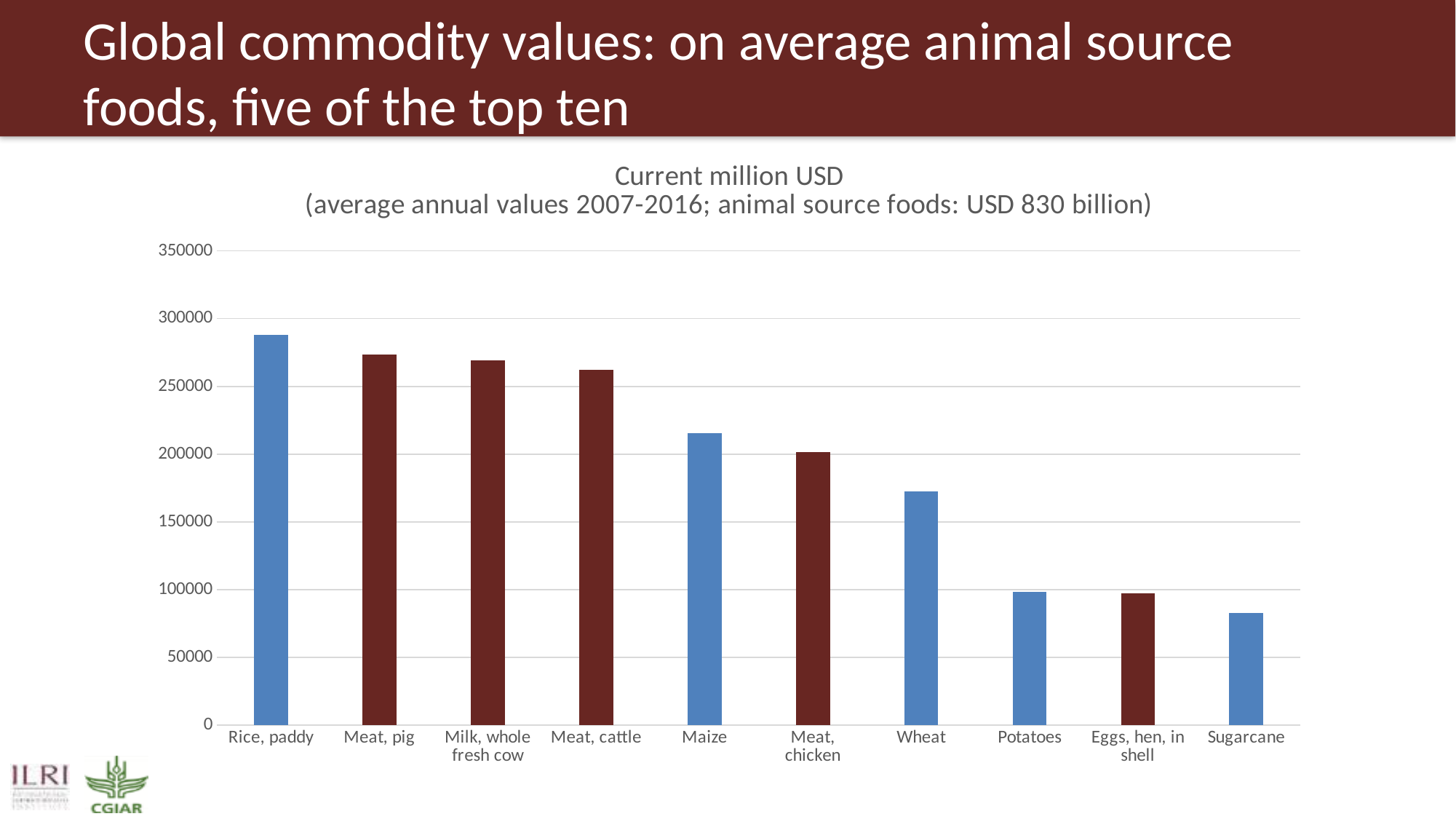
What kind of chart is shown on the slide? bar chart Is the value for Milk, whole fresh cow greater or less than 250000? greater What is the first line of the chart's title? Current million USD Which commodity has the lowest value on the chart? Sugarcane How many commodities are plotted on the chart? 10 Do the values rise or fall moving from left to right along the x axis? fall Which commodity has the highest value on the chart? Rice, paddy Which has the larger value, Maize or Meat, chicken? Maize Which has the larger value, Wheat or Potatoes? Wheat Is the value for Sugarcane greater or less than 100000? less Is the value for Wheat greater or less than 200000? less